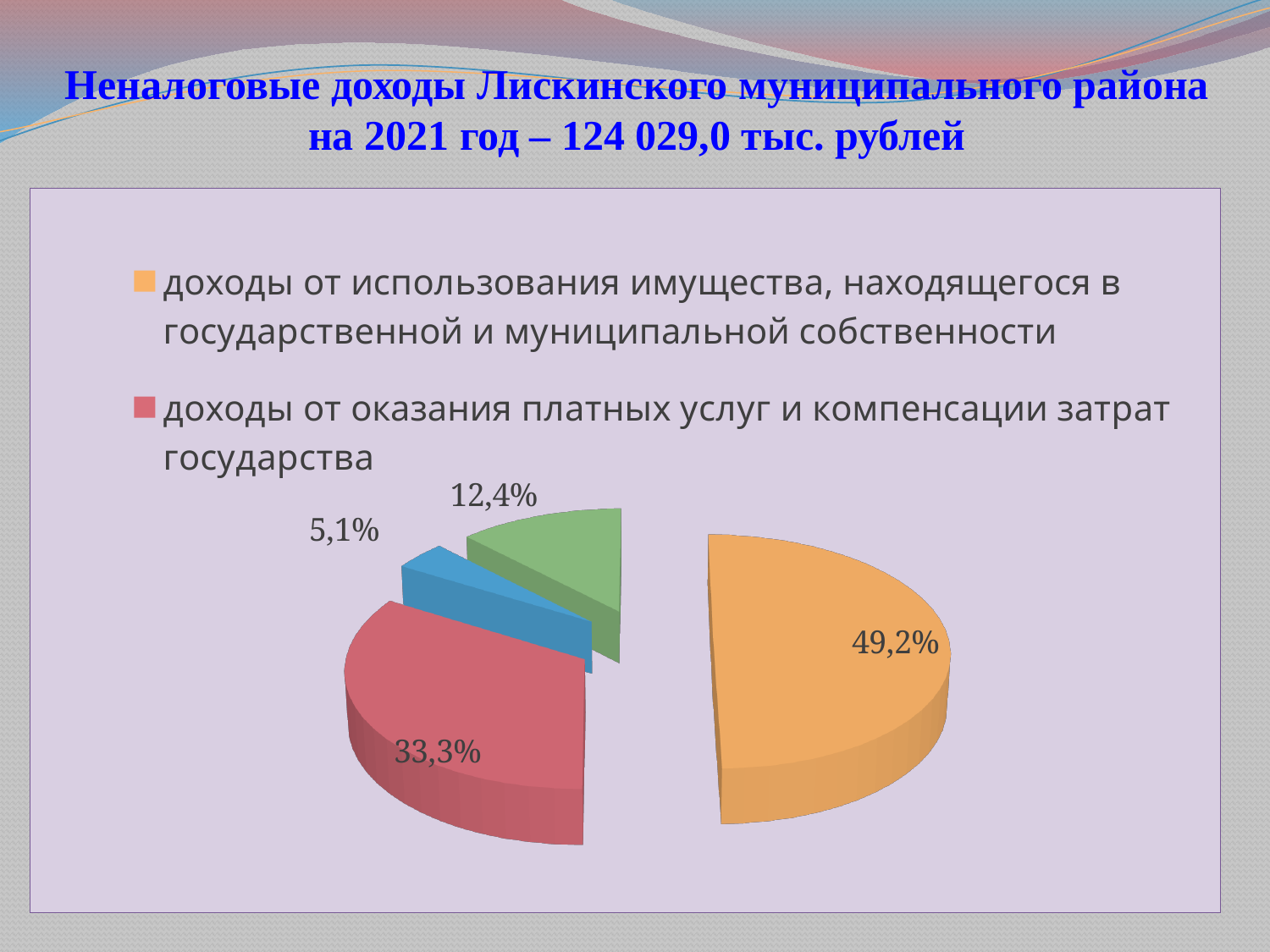
Which category has the largest slice of the pie? доходы от использования имущества, находящегося в государственной и муниципальной собственности Which is larger: the slice for доходы от оказания платных услуг и компенсации затрат государства or the slice labelled 12,4%? доходы от оказания платных услуг и компенсации затрат государства What total amount of non-tax revenue for 2021 is stated in the slide title? 124 029,0 тыс. рублей What kind of chart is shown on the slide? pie chart What share of the pie is labelled for доходы от оказания платных услуг и компенсации затрат государства? 33,3% What is the largest percentage shown on the pie chart? 49,2% How many slices does the pie chart have? 4 What is the smallest percentage shown on the pie chart? 5,1% What share of the pie is labelled for доходы от использования имущества, находящегося в государственной и муниципальной собственности? 49,2% What colour is the slice for доходы от оказания платных услуг и компенсации затрат государства? red How many entries does the legend list? 2 What is the difference in percentage points between the slice labelled 49,2% and the slice labelled 33,3%? 15,9